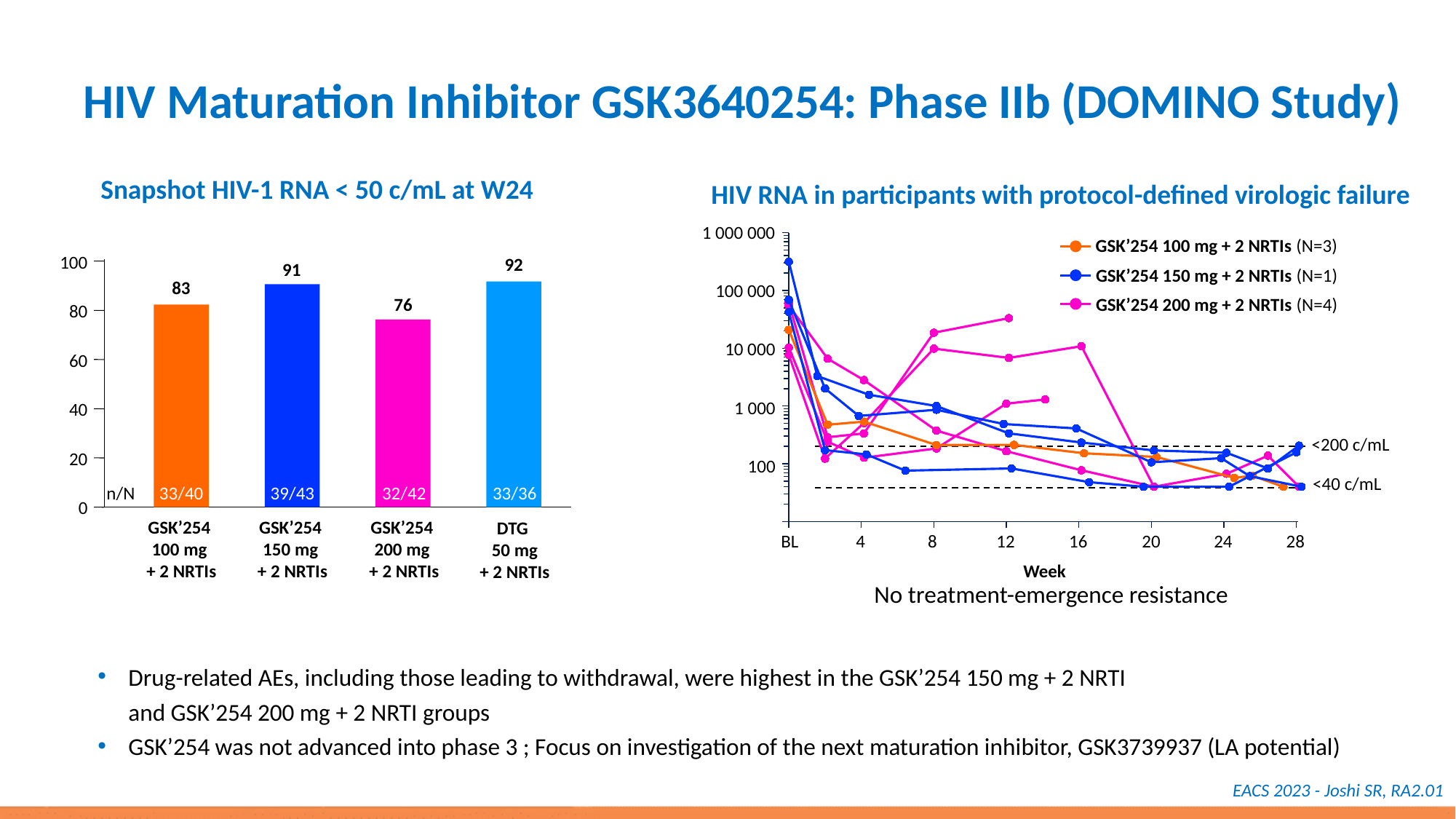
In the 'Snapshot HIV-1 RNA < 50 c/mL at W24' chart, what is the value for GSK'254 150 mg + 2 NRTIs? 91 In the 'Snapshot HIV-1 RNA < 50 c/mL at W24' chart, which group has the highest value? DTG 50 mg + 2 NRTIs In the 'HIV RNA in participants with protocol-defined virologic failure' chart, how many participants (N) are in the GSK'254 200 mg + 2 NRTIs group according to the legend? N=4 In the 'Snapshot HIV-1 RNA < 50 c/mL at W24' chart, how many treatment groups are shown? 4 In the 'Snapshot HIV-1 RNA < 50 c/mL at W24' chart, which group has the lowest value? GSK'254 200 mg + 2 NRTIs In the 'Snapshot HIV-1 RNA < 50 c/mL at W24' chart, which is larger: the value for GSK'254 150 mg + 2 NRTIs or for GSK'254 100 mg + 2 NRTIs? GSK'254 150 mg + 2 NRTIs In the 'Snapshot HIV-1 RNA < 50 c/mL at W24' chart, what is the value for GSK'254 200 mg + 2 NRTIs? 76 In the 'HIV RNA in participants with protocol-defined virologic failure' chart, how many series does the legend list? 3 What kind of chart is the 'HIV RNA in participants with protocol-defined virologic failure' chart? Line chart In the 'Snapshot HIV-1 RNA < 50 c/mL at W24' chart, what is the n/N shown for the GSK'254 100 mg + 2 NRTIs bar? 33/40 What kind of chart is the 'Snapshot HIV-1 RNA < 50 c/mL at W24' chart? Bar chart In the 'Snapshot HIV-1 RNA < 50 c/mL at W24' chart, what is the difference between the DTG 50 mg + 2 NRTIs value and the GSK'254 100 mg + 2 NRTIs value? 9